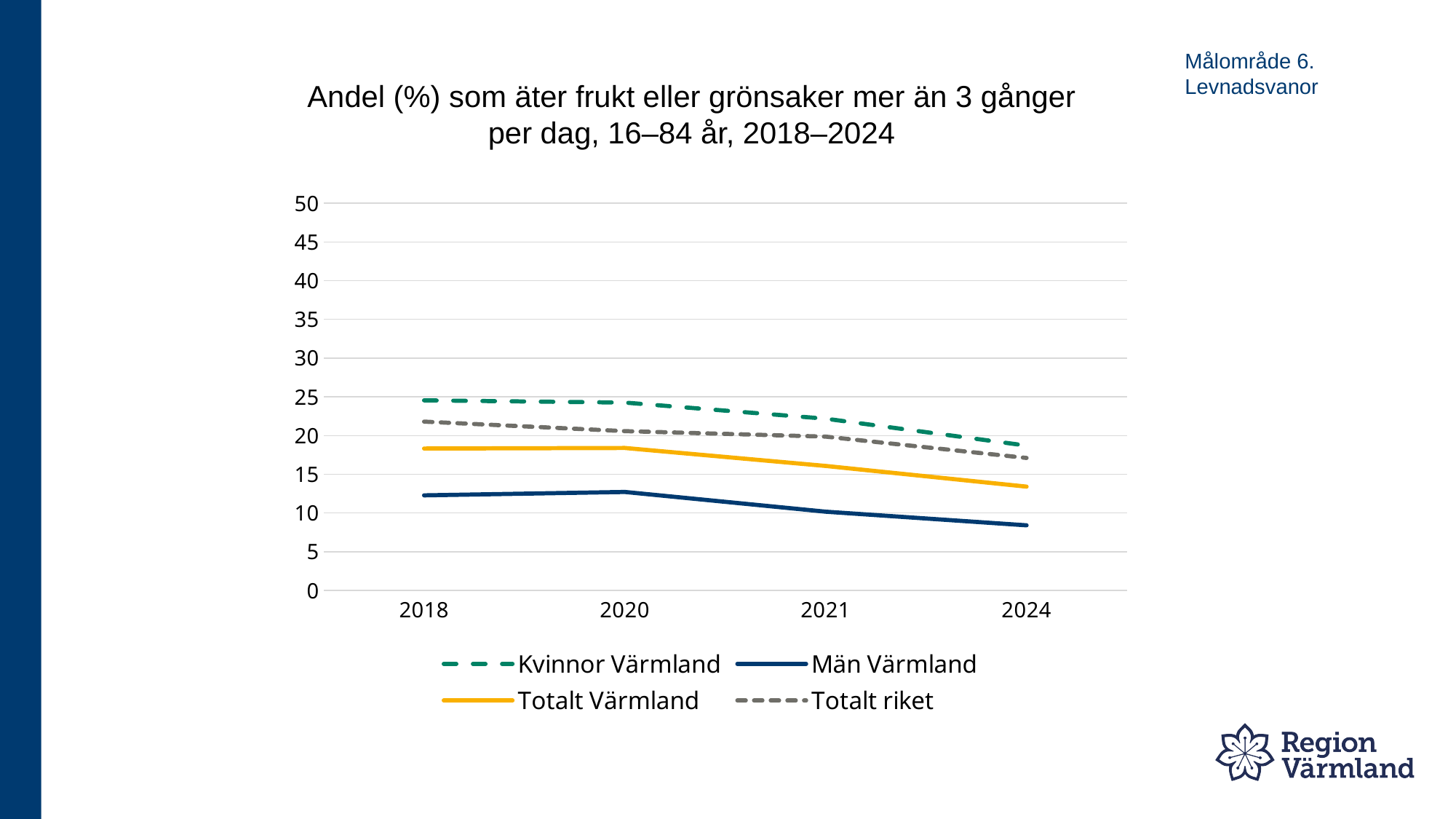
Is the value for Kvinnor Värmland in 2018 greater or less than 20? greater Which series is drawn as a green dashed line? Kvinnor Värmland What kind of chart is shown on the slide? line chart How many years are shown on the x axis? 4 Which series has the highest value in 2024? Kvinnor Värmland How many series does the legend list? 4 Which series has the lowest value in 2018? Män Värmland In 2021, which is larger: Totalt riket or Totalt Värmland? Totalt riket Does the value for Män Värmland rise or fall from 2021 to 2024? fall Is the value for Totalt Värmland in 2024 greater or less than 15? less Does the value for Kvinnor Värmland rise or fall from 2018 to 2024? fall Is the value for Män Värmland in 2024 greater or less than 10? less